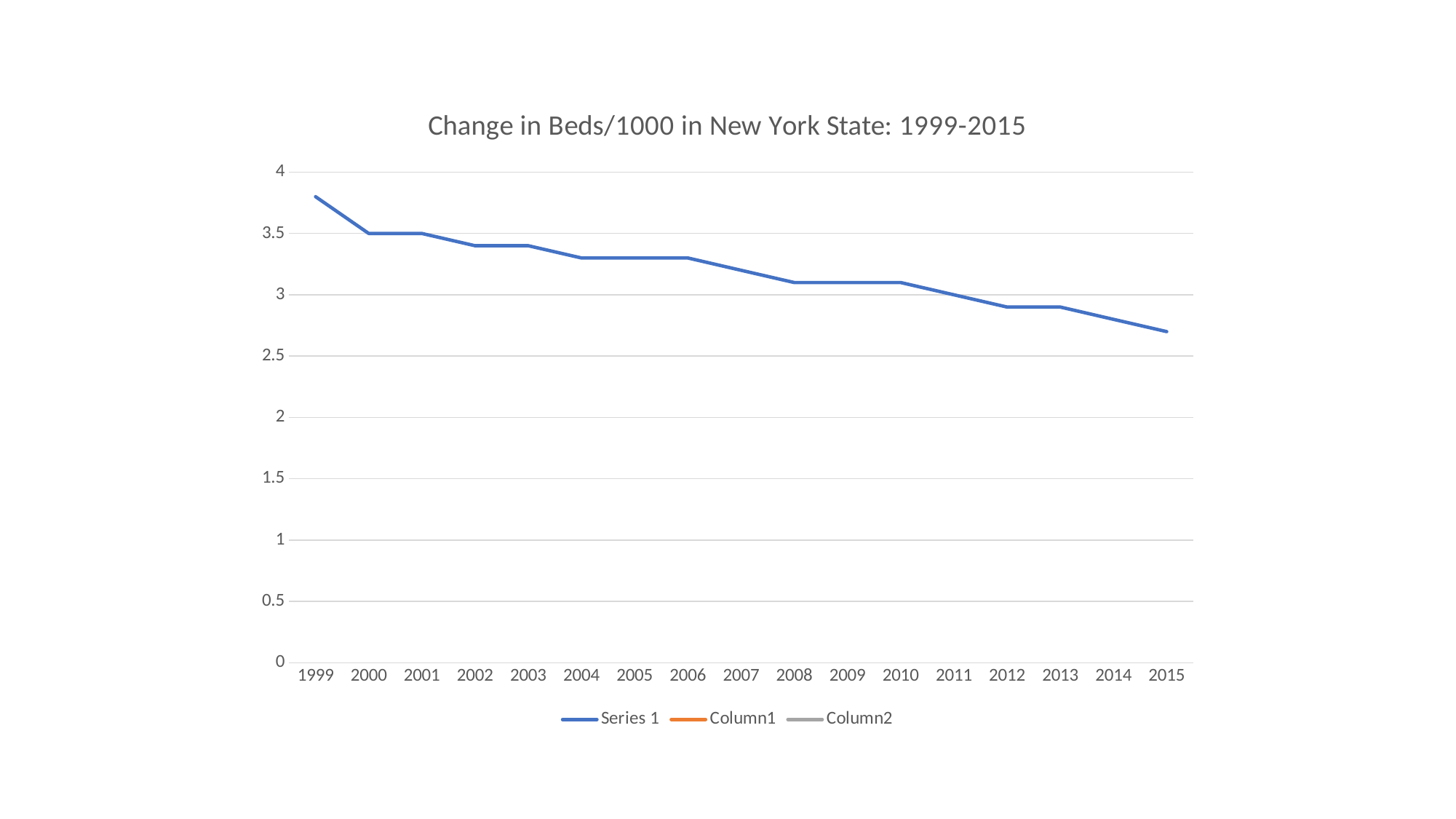
What is the title of the chart? Change in Beds/1000 in New York State: 1999-2015 Is the value for 2015 greater or less than 3? less Is the value for 2008 greater or less than 3? greater What kind of chart is shown on the slide? line chart Which year has the highest value? 1999 How many series does the legend list? 3 Which year has the larger value, 2002 or 2012? 2002 How many years are shown on the x axis? 17 Is the value for 2004 greater or less than 3.5? less Which year has the lowest value? 2015 Do the values rise or fall from 1999 to 2015? fall